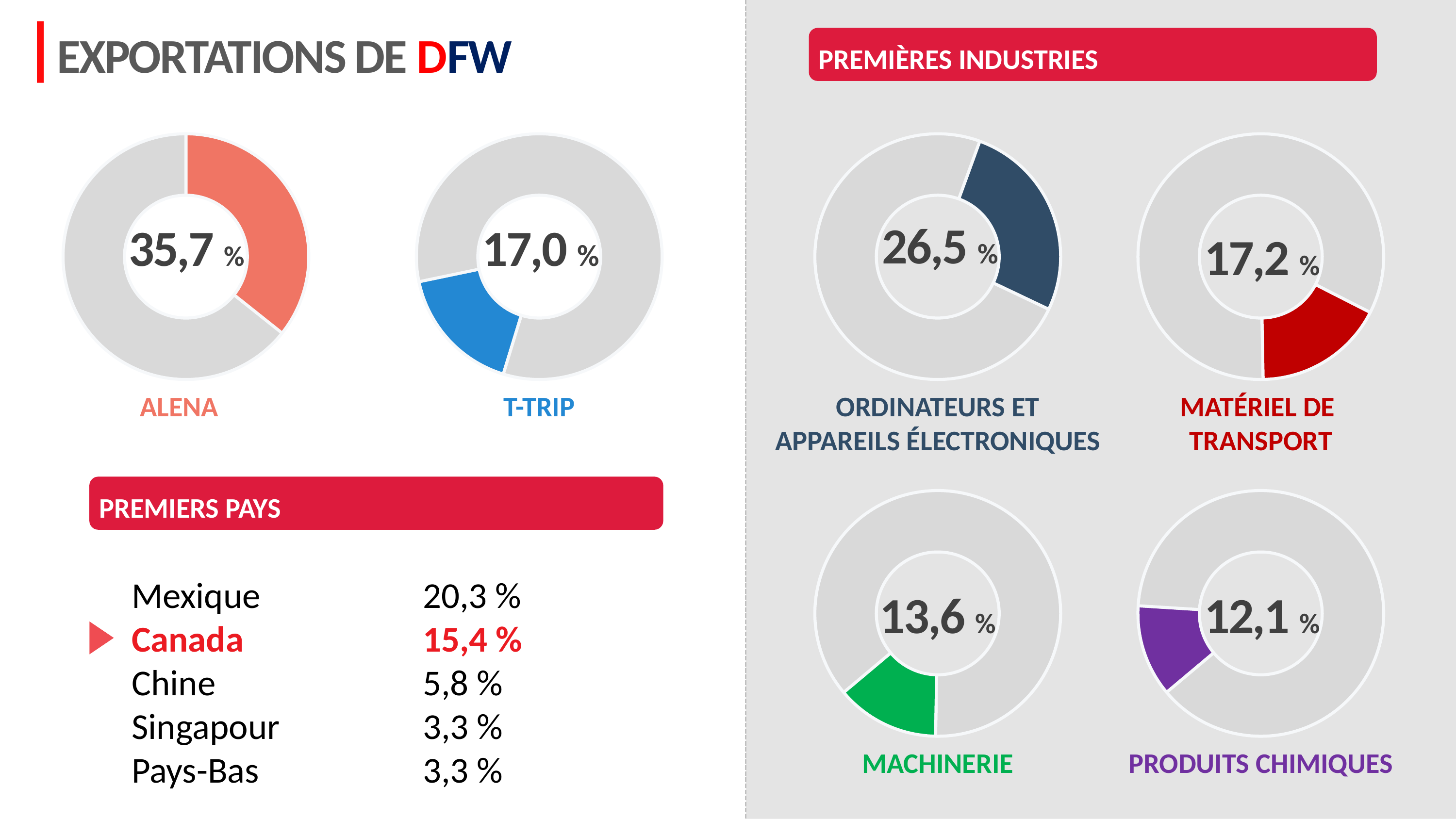
What kind of chart is used to show the ALENA and T-TRIP percentages? Donut chart In the Premières industries section, what percentage is shown for Produits chimiques? 12,1 % In the Premières industries section, what percentage is shown for Matériel de transport? 17,2 % In the ALENA donut chart, what percentage is shown? 35,7 % Among the four Premières industries donut charts, which industry has the highest percentage? Ordinateurs et appareils électroniques Which is larger, the percentage for Matériel de transport or the percentage for Machinerie? Matériel de transport In the Premières industries section, what percentage is shown for Machinerie? 13,6 % Among the four Premières industries donut charts, which industry has the lowest percentage? Produits chimiques What is the difference between the ALENA percentage and the T-TRIP percentage? 18,7 % In the T-TRIP donut chart, what percentage is shown? 17,0 % How many donut charts are shown in the Premières industries section? 4 In the Premières industries section, what percentage is shown for Ordinateurs et appareils électroniques? 26,5 %